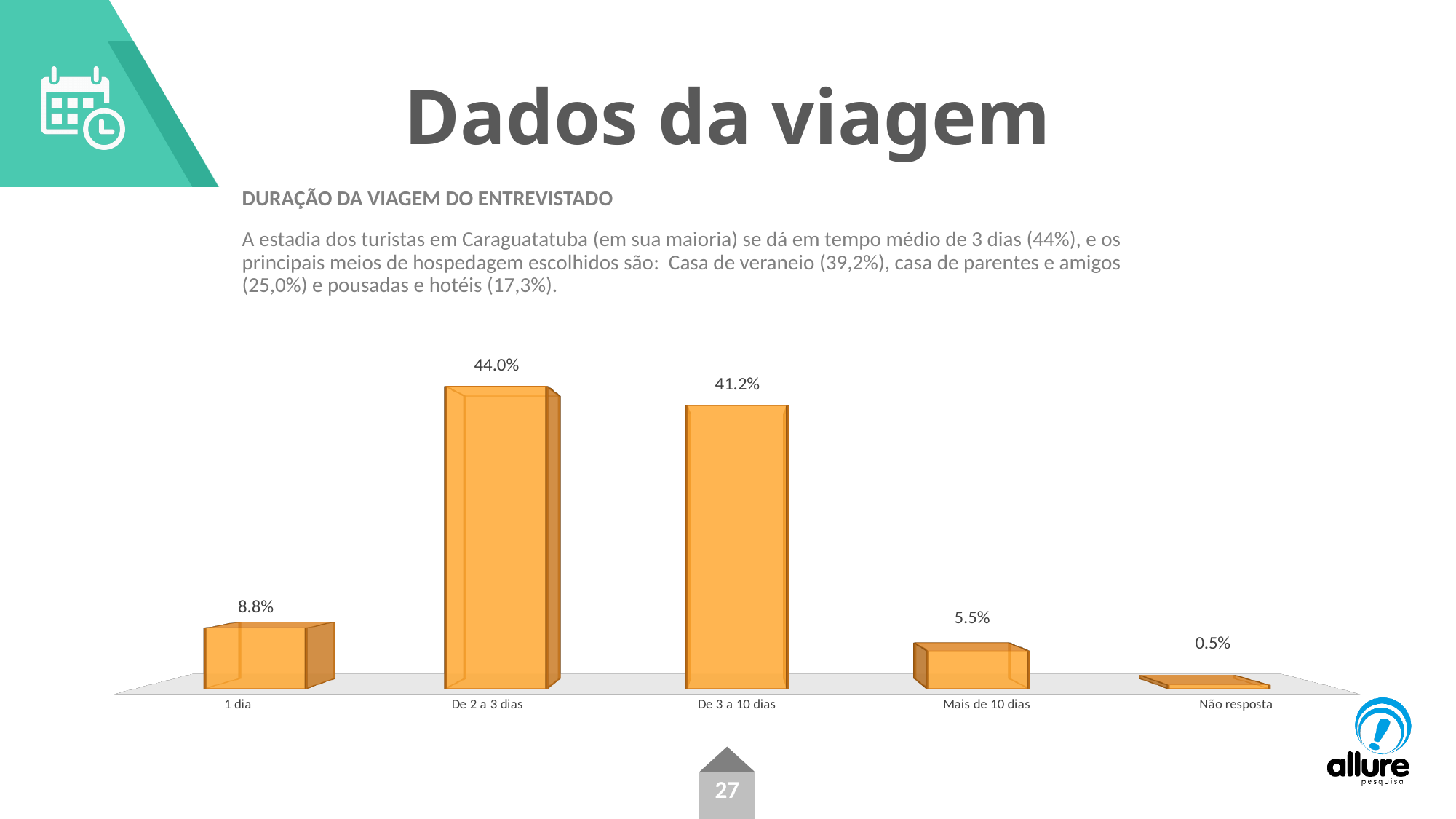
What is the difference between the values for 'De 2 a 3 dias' and 'De 3 a 10 dias'? 2.8% What is the value for 'De 2 a 3 dias'? 44.0% What colour are the bars in the chart? Orange What kind of chart is shown on the slide? Bar chart Which is larger, the value for '1 dia' or the value for 'Mais de 10 dias'? 1 dia Which category has the highest value? De 2 a 3 dias What is the value for 'Não resposta'? 0.5% How many categories are shown on the chart? 5 Which category has the lowest value? Não resposta What is the value for '1 dia'? 8.8% What is the value for 'Mais de 10 dias'? 5.5% What is the difference between the values for '1 dia' and 'Não resposta'? 8.3%